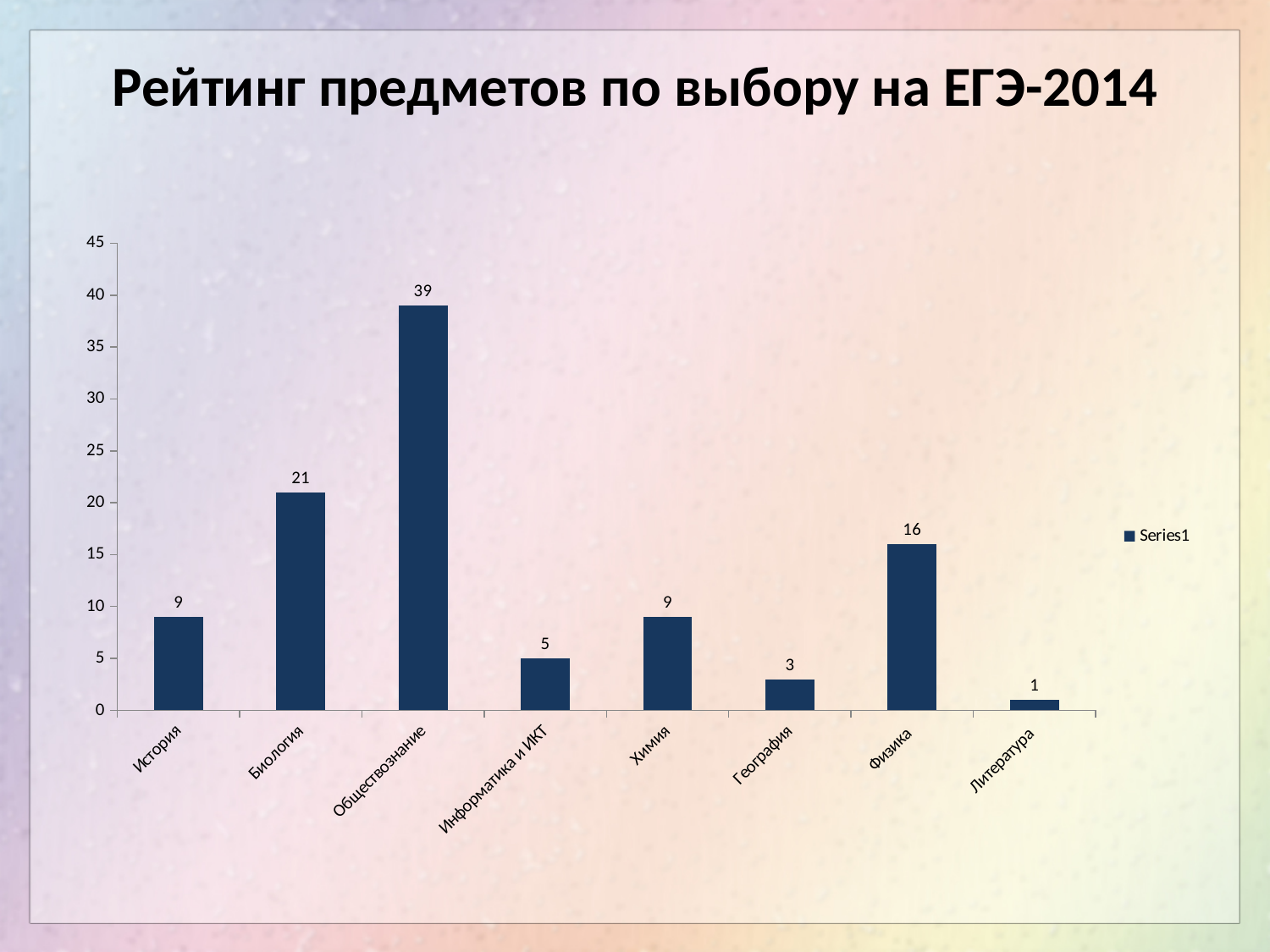
Which subject has the highest value? Обществознание What is the value for Информатика и ИКТ? 5 What is the difference between the values for Обществознание and Биология? 18 What is the title of the chart on the slide? Рейтинг предметов по выбору на ЕГЭ-2014 Which is larger, the value for Физика or the value for Химия? Физика How many subjects are shown on the chart? 8 What is the value for Физика? 16 How many series does the legend list? 1 Which subject has the lowest value? Литература Is the value for Биология greater or less than 20? greater What is the value for Обществознание? 39 What kind of chart is shown on the slide? bar chart